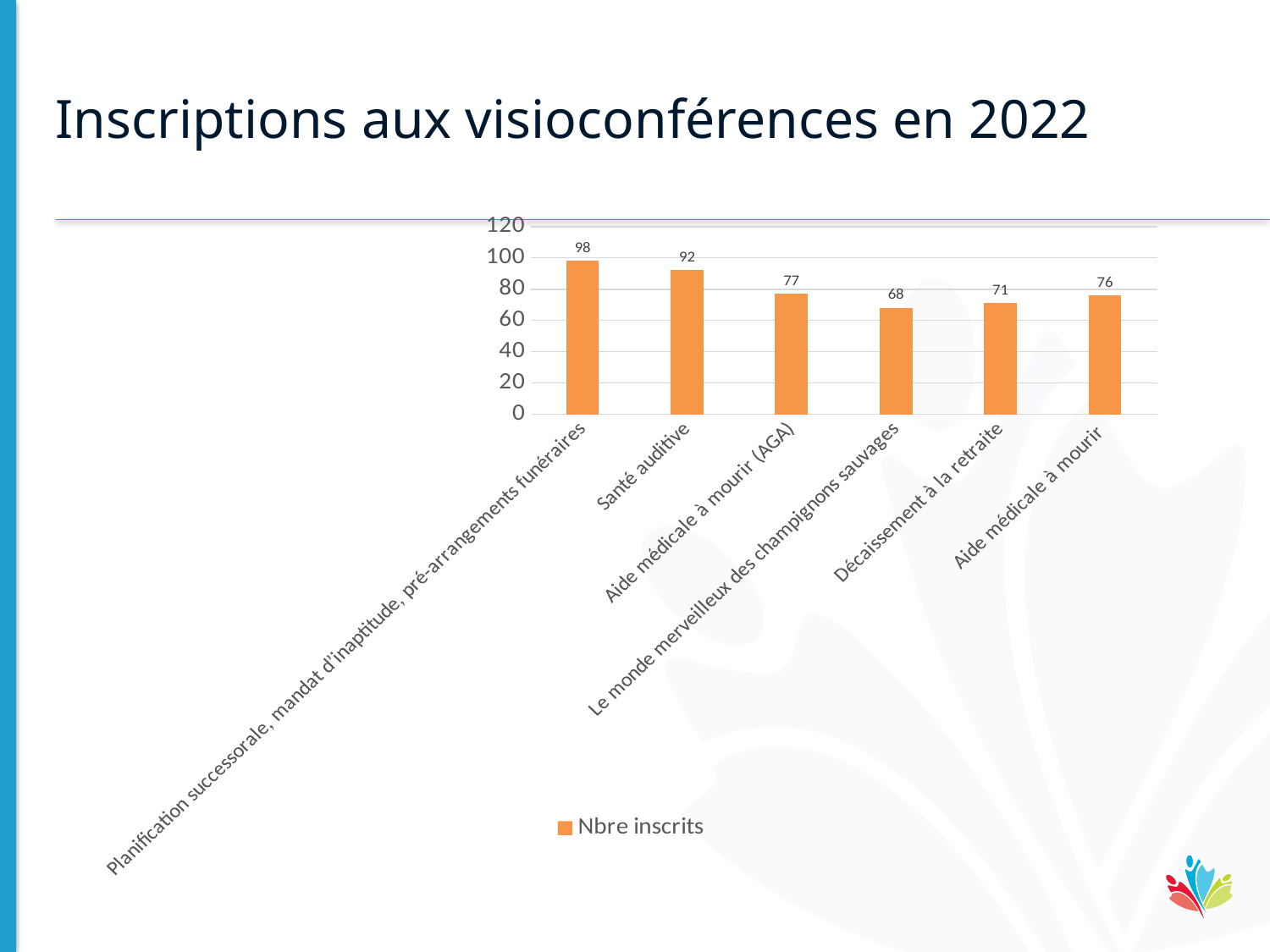
What is the value for Le monde merveilleux des champignons sauvages? 68 Is the value for Aide médicale à mourir (AGA) greater or less than 60? greater What is the name of the series shown in the legend? Nbre inscrits What kind of chart is shown on the slide? Bar chart What is the difference between the values for Santé auditive and Aide médicale à mourir (AGA)? 15 What is the value for Santé auditive? 92 How many series does the legend list? 1 What is the value for Décaissement à la retraite? 71 Which is larger, the value for Aide médicale à mourir or the value for Décaissement à la retraite? Aide médicale à mourir How many categories are shown on the chart? 6 Which category has the lowest value? Le monde merveilleux des champignons sauvages Which category has the highest value? Planification successorale, mandat d'inaptitude, pré-arrangements funéraires